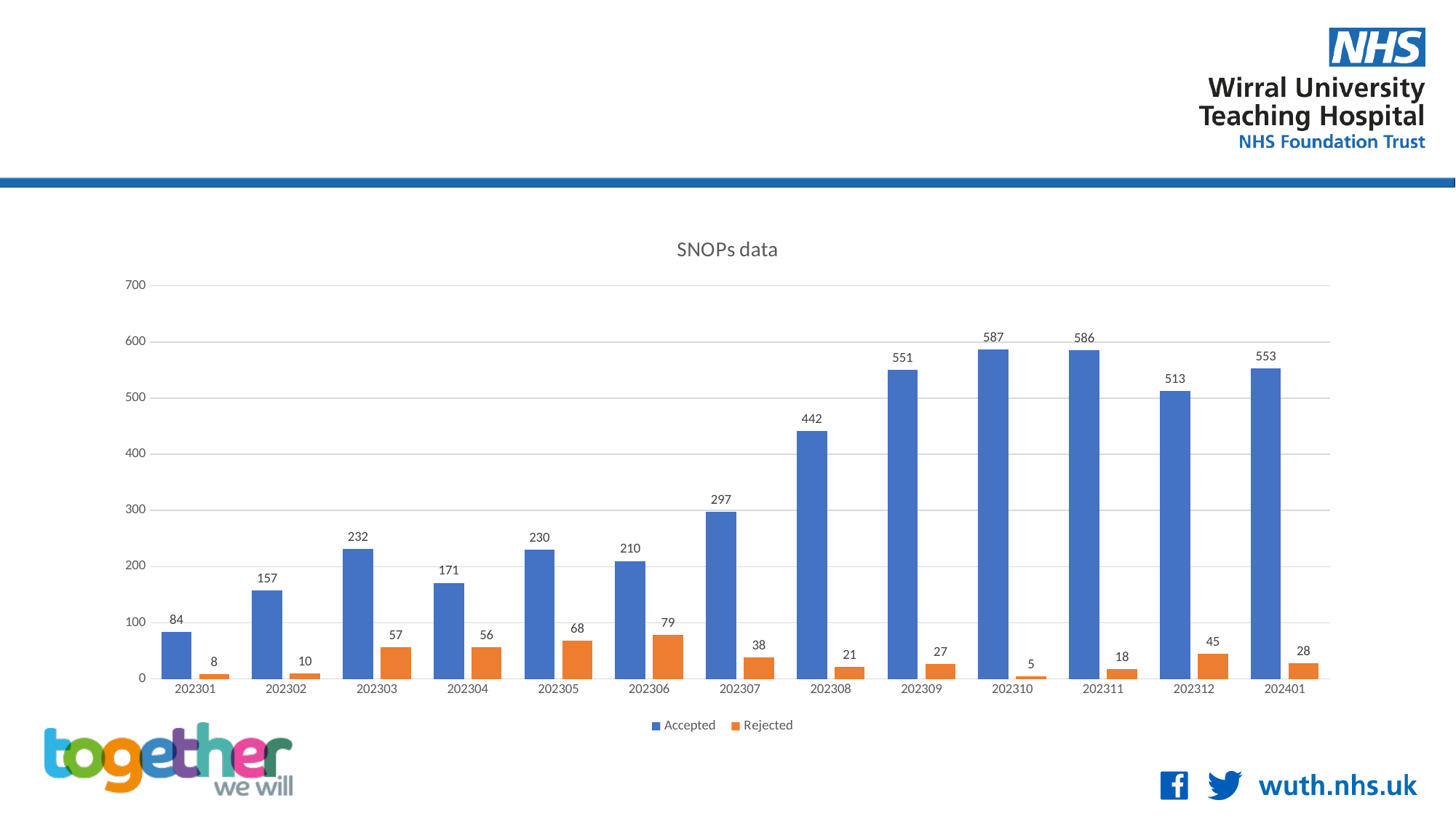
Which is larger, the Rejected value for 202303 or for 202304? 202303 Which month has the lowest Rejected value? 202310 Is the Accepted value for 202307 greater or less than 300? less What is the difference between the Accepted values for 202401 and 202312? 40 What kind of chart is shown on the slide? bar chart What is the title of the chart? SNOPs data How many months are shown on the x axis? 13 Do the Accepted values generally rise or fall from 202301 to 202310? rise How many series does the legend list? 2 What is the Accepted value for 202308? 442 Which month has the highest Accepted value? 202310 What is the Rejected value for 202306? 79